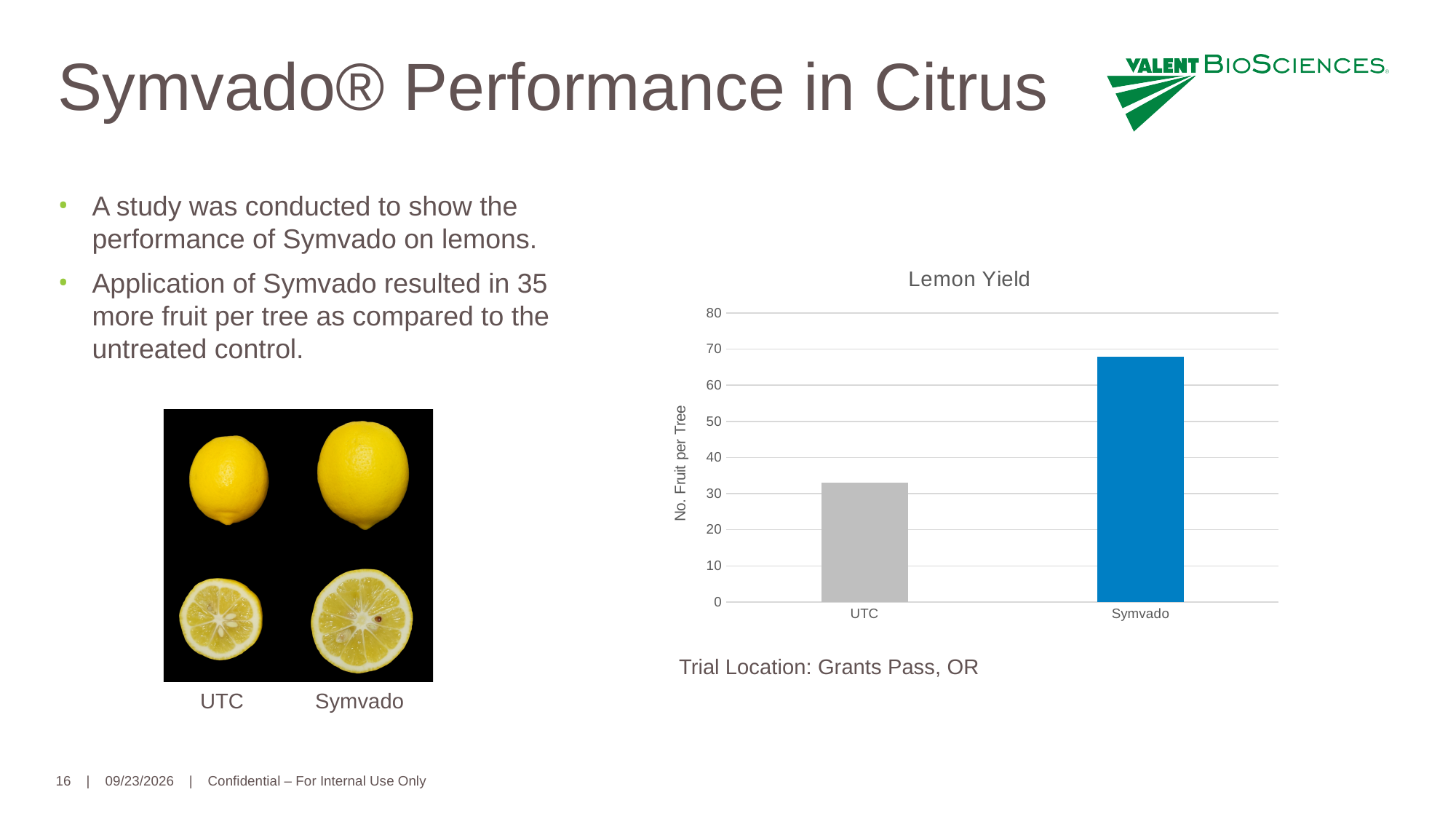
What kind of chart is shown on the slide? bar chart Which is larger in the Lemon Yield chart, the value for UTC or the value for Symvado? Symvado Which category has the highest value in the Lemon Yield chart? Symvado Do the values in the Lemon Yield chart rise or fall from UTC to Symvado? rise What is the title of the chart? Lemon Yield Is the value for UTC in the Lemon Yield chart greater or less than 40? less What is the y-axis label of the Lemon Yield chart? No. Fruit per Tree Is the value for Symvado in the Lemon Yield chart greater or less than 80? less Is the value for UTC in the Lemon Yield chart greater or less than 20? greater Which category has the lowest value in the Lemon Yield chart? UTC How many categories are shown in the Lemon Yield chart? 2